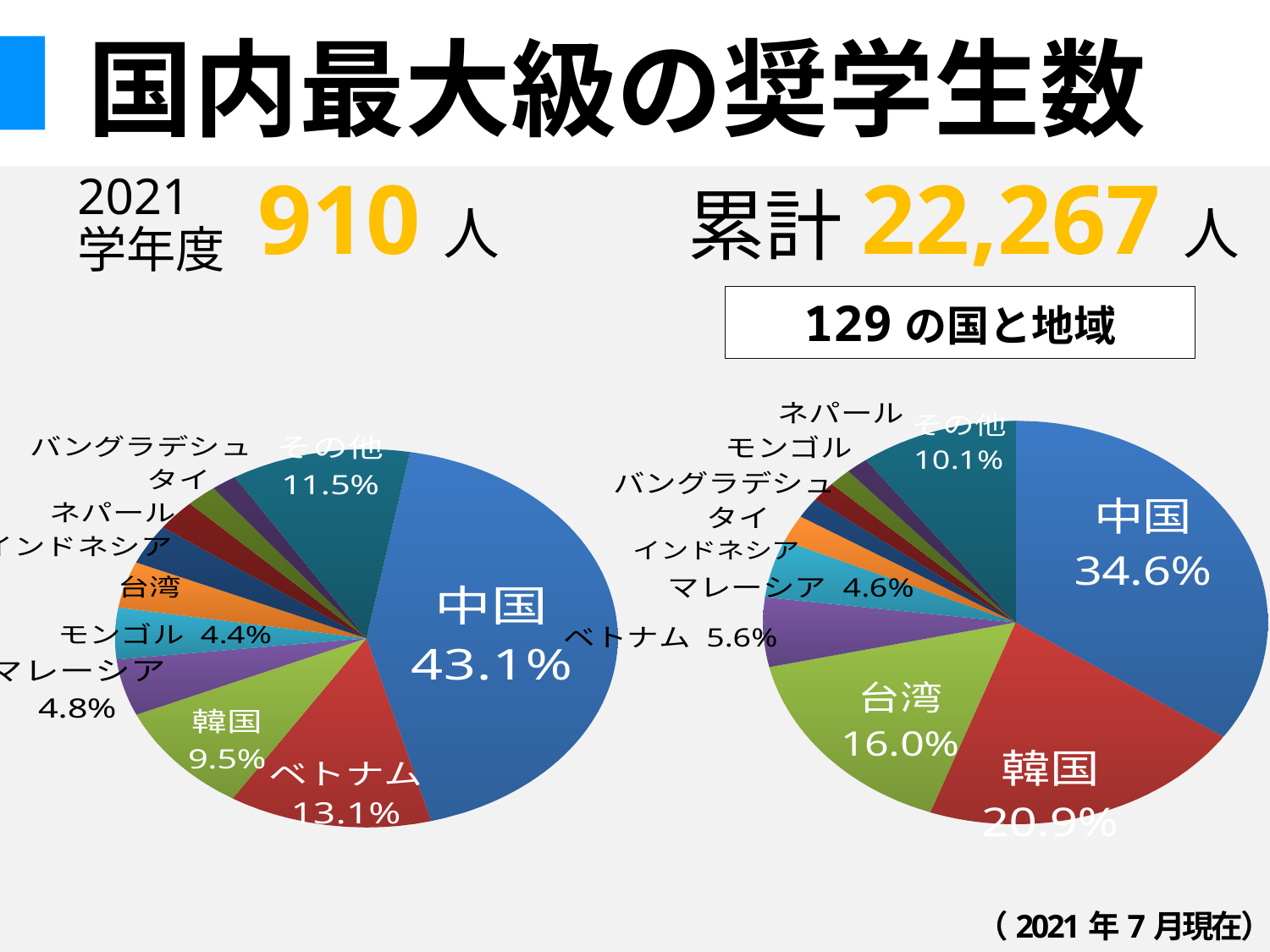
What type of chart is used on the right side of the slide? Pie chart In the right pie chart, which is larger, the share of ベトナム or the share of その他? その他 In the right pie chart, which category has the largest slice? 中国 In the left pie chart, what share is shown for 中国? 43.1% In the left pie chart, which category has the largest slice? 中国 In the left pie chart, which is larger, the share of 韓国 or the share of マレーシア? 韓国 In the right pie chart, what share is shown for 韓国? 20.9% In the left pie chart, what share is shown for ベトナム? 13.1% In the right pie chart, what is the difference between the shares of 韓国 and 台湾? 4.9% In the left pie chart, what is the difference between the shares of 中国 and ベトナム? 30.0% In the right pie chart, what share is shown for 台湾? 16.0% How many slices does the left pie chart have? 11